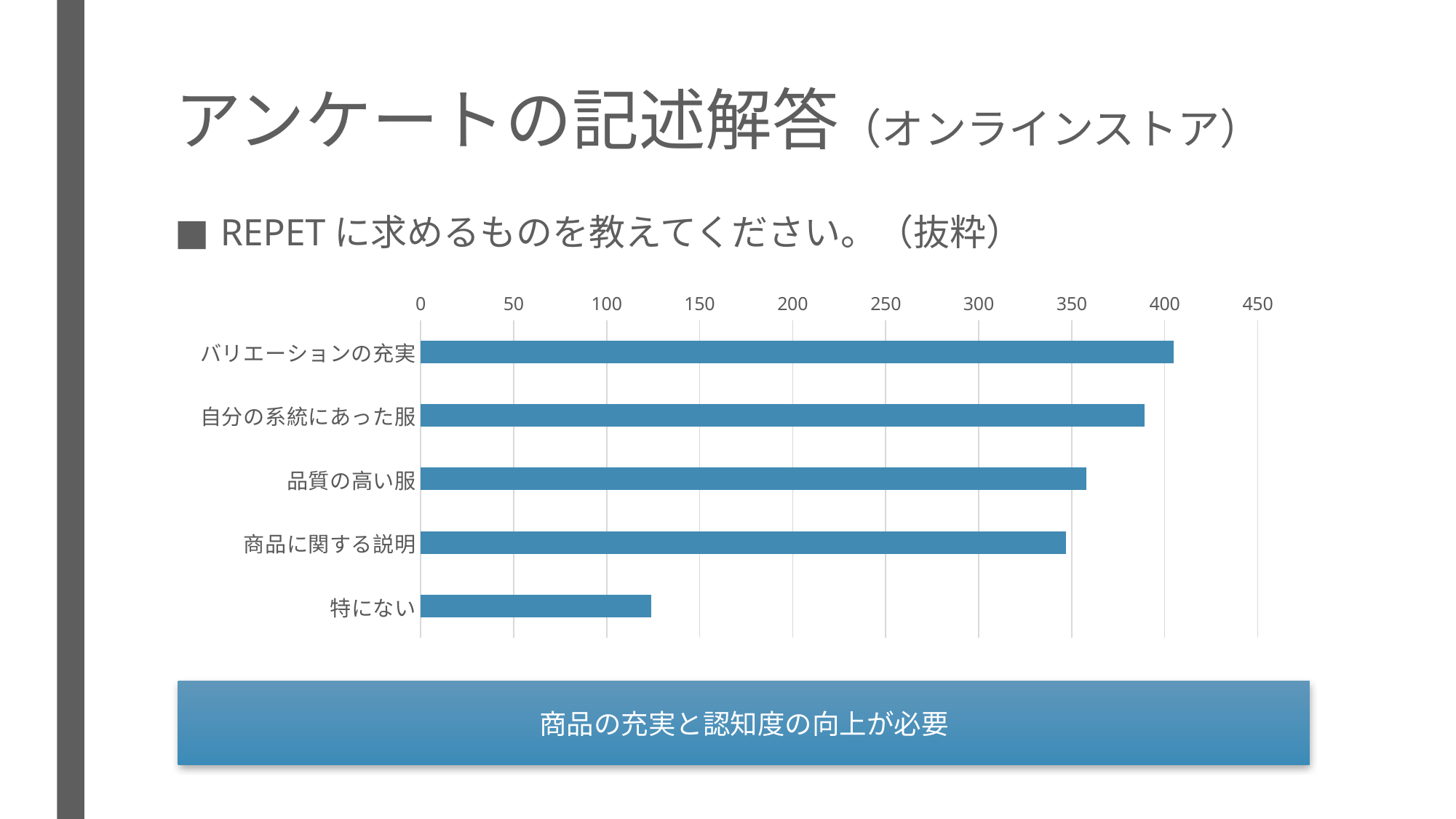
Which is larger, the value for バリエーションの充実 or the value for 品質の高い服? バリエーションの充実 Is the value for 品質の高い服 greater or less than 400? less How many categories are shown in the bar chart? 5 What kind of chart is shown on the slide? bar chart What is the highest tick value shown on the value axis of the bar chart? 450 Is the value for 商品に関する説明 greater or less than 300? greater Is the value for 特にない greater or less than 150? less Which category has the lowest value in the bar chart? 特にない Which is larger, the value for 特にない or the value for 商品に関する説明? 商品に関する説明 Which category has the highest value in the bar chart? バリエーションの充実